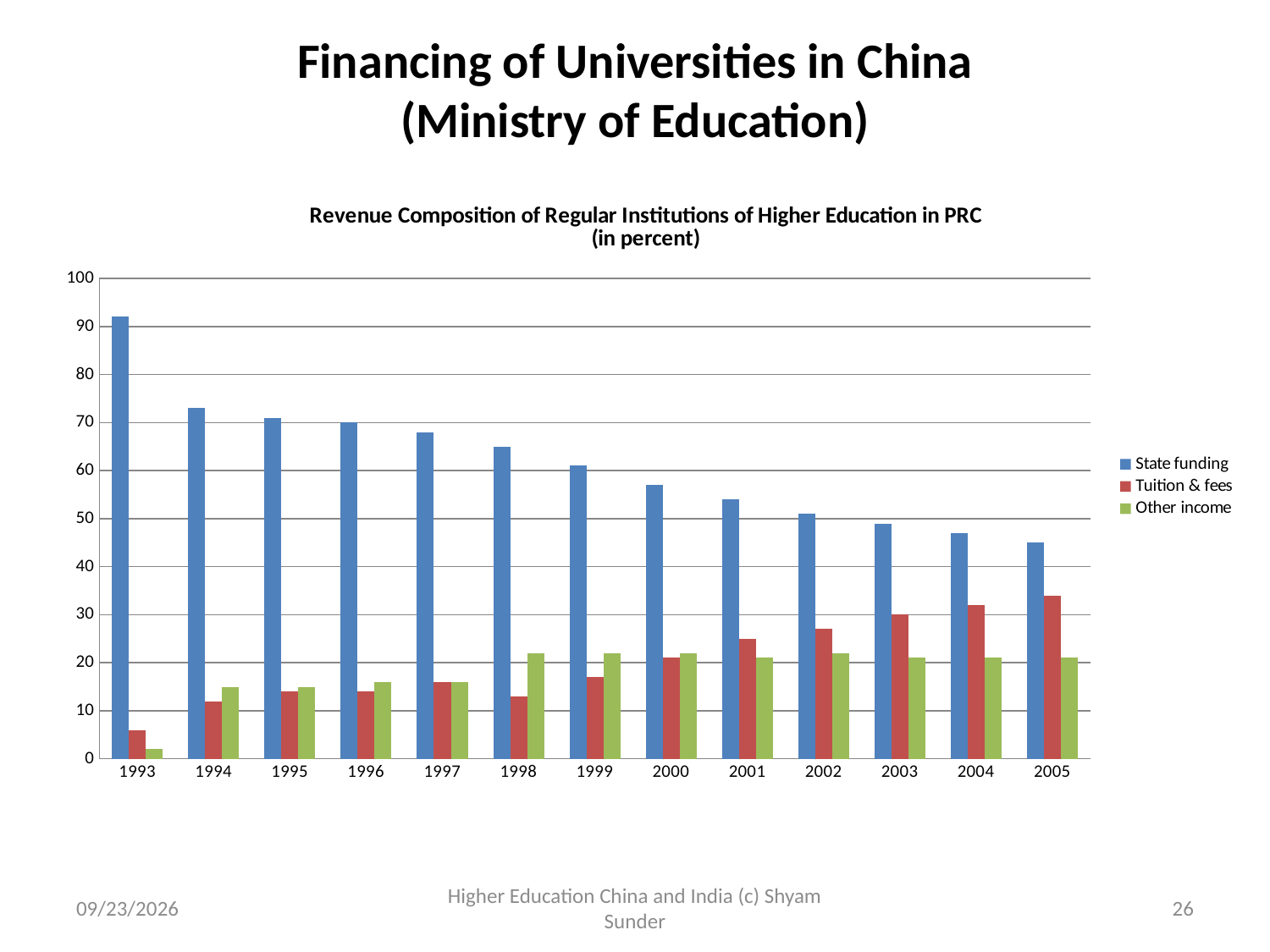
Which year has the lowest Tuition & fees value? 1993 Which is larger in 2005, State funding or Tuition & fees? State funding Which year has the lowest State funding value? 2005 How many years are shown on the x axis? 13 Which year has the highest Tuition & fees value? 2005 What kind of chart is shown on the slide? bar chart Which year has the highest State funding value? 1993 How many series does the legend list? 3 Is the Tuition & fees value for 2005 greater or less than 30? greater Is the Other income value for 1993 greater or less than 10? less Is the State funding value for 1993 greater or less than 90? greater Does State funding rise or fall from 1993 to 2005? fall